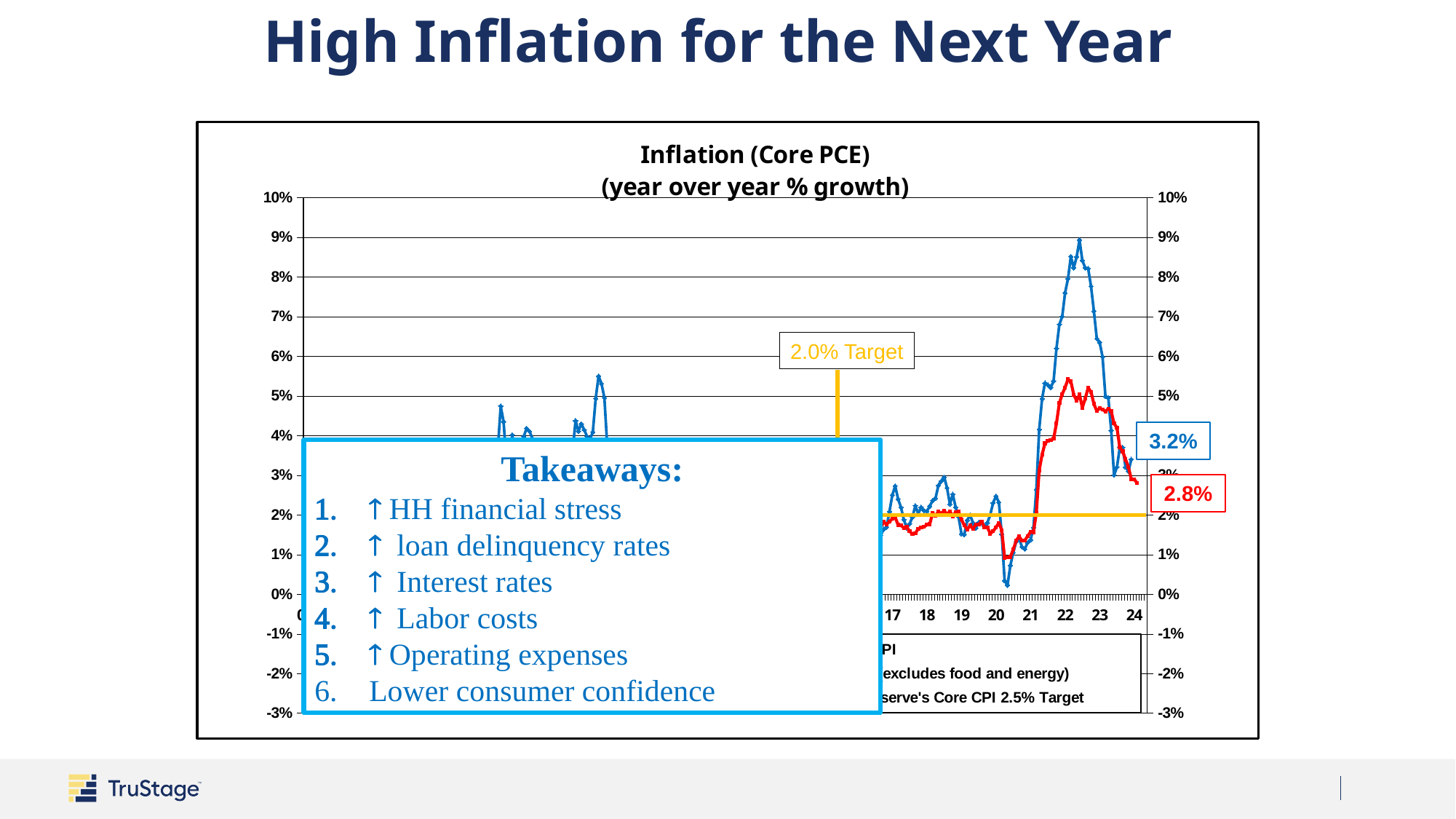
Is the lowest point of the blue line around 2020 greater or less than 1%? less What is the title of the chart? Inflation (Core PCE) (year over year % growth) Which line has the higher labelled latest value, the blue line or the red line? the blue line What kind of chart is shown on the slide? line chart Is the peak of the red line around 2022 greater or less than 6%? less From its 2022 peak to 2024, does the blue line rise or fall? fall Is the peak of the blue line around 2022 greater or less than 8%? greater What is the latest value labelled on the blue line? 3.2% What is the difference between the labelled latest values of the blue line (3.2%) and the red line (2.8%)? 0.4 percentage points What is the latest value labelled on the red line? 2.8% What target value is marked by the horizontal yellow line? 2.0% Target What is the highest value shown on the vertical axis? 10%